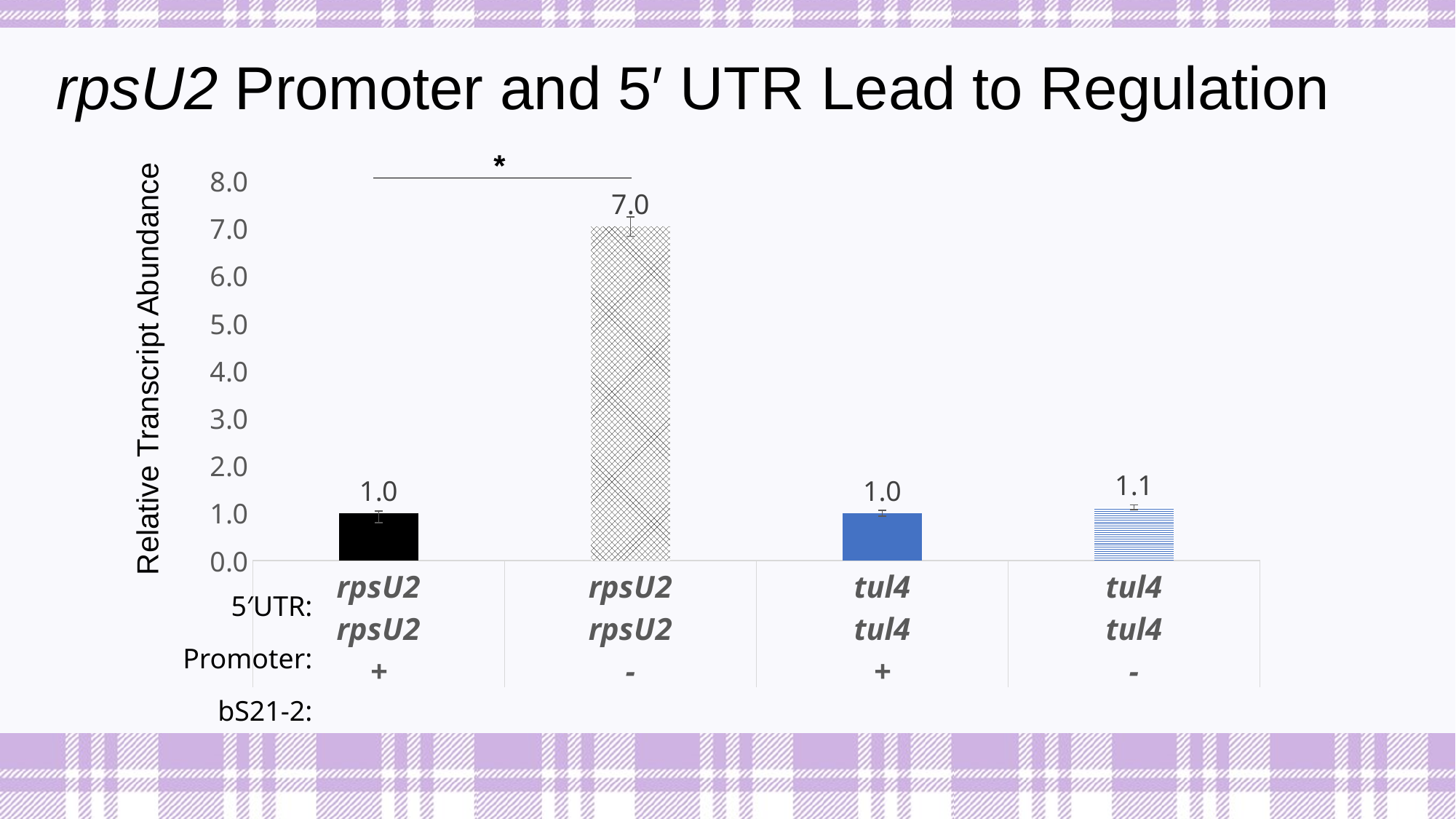
What is the relative transcript abundance for the rpsU2 5′UTR / rpsU2 promoter construct with bS21-2 present (+)? 1.0 Is the value for the rpsU2 construct with bS21-2 absent (-) greater or less than 6.0? greater What is the label of the vertical axis? Relative Transcript Abundance What is the relative transcript abundance for the tul4 5′UTR / tul4 promoter construct with bS21-2 absent (-)? 1.1 How many bars are plotted in the chart? 4 What is the relative transcript abundance for the rpsU2 5′UTR / rpsU2 promoter construct with bS21-2 absent (-)? 7.0 Which construct has the highest relative transcript abundance? rpsU2 5′UTR / rpsU2 promoter, bS21-2 - What is the maximum value shown on the vertical axis? 8.0 Which is larger: the relative transcript abundance of the rpsU2 construct with bS21-2 absent (-) or the tul4 construct with bS21-2 absent (-)? rpsU2 construct with bS21-2 absent (-) What is the difference in relative transcript abundance between the rpsU2 construct without bS21-2 (-) and the rpsU2 construct with bS21-2 (+)? 6.0 What is the relative transcript abundance for the tul4 5′UTR / tul4 promoter construct with bS21-2 present (+)? 1.0 What kind of chart is shown on the slide? Bar chart